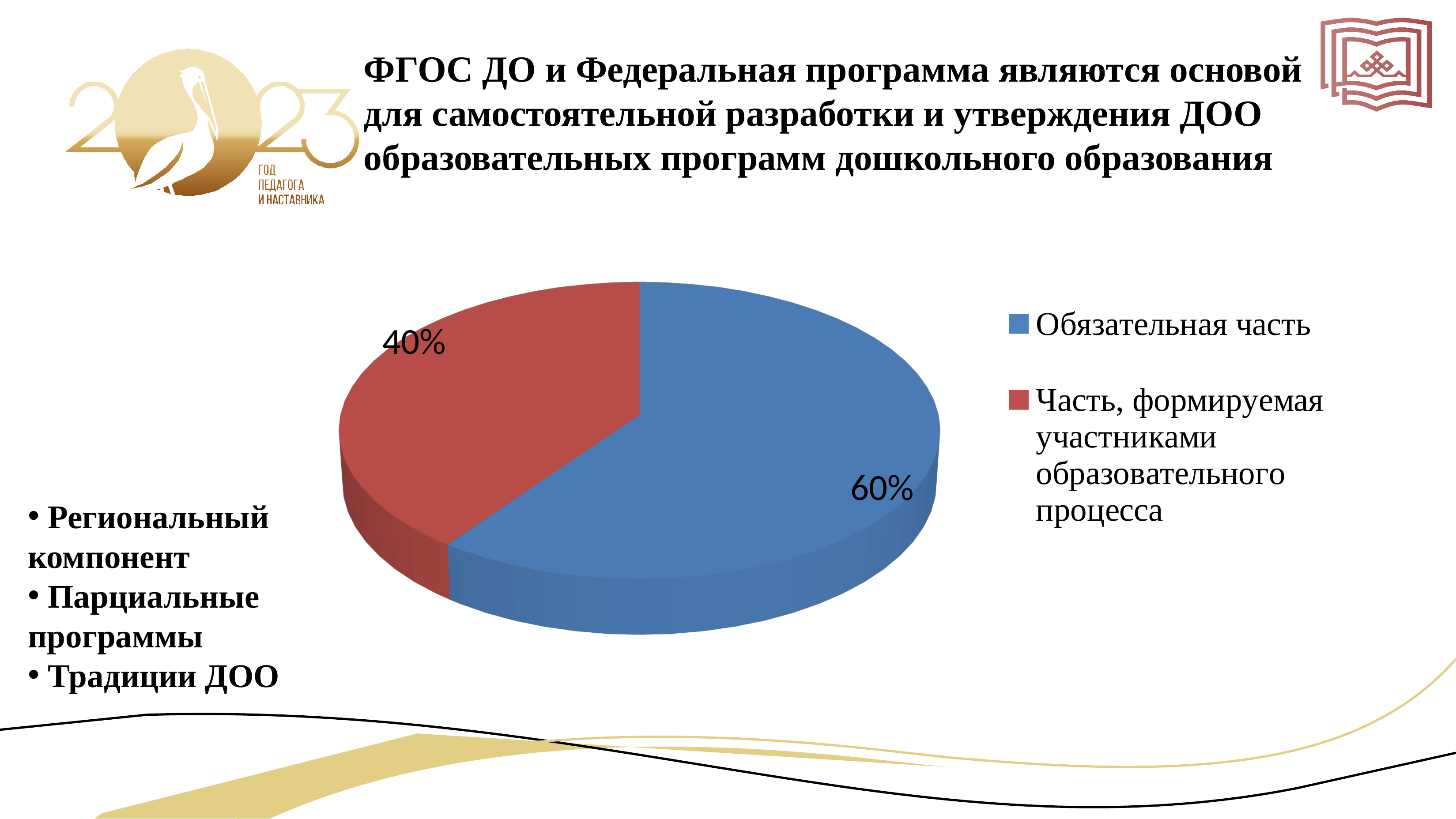
What colour is the "Обязательная часть" slice? Blue What share of the pie does "Обязательная часть" take? 60% How many entries does the legend list? 2 Which slice of the pie is the largest? Обязательная часть What is the difference in percentage points between the "Обязательная часть" slice and the "Часть, формируемая участниками образовательного процесса" slice? 20% Which is larger: the "Обязательная часть" slice or the "Часть, формируемая участниками образовательного процесса" slice? Обязательная часть What share of the pie does "Часть, формируемая участниками образовательного процесса" take? 40% Which slice of the pie is the smallest? Часть, формируемая участниками образовательного процесса How many slices does the pie chart have? 2 What kind of chart is shown on the slide? Pie chart What colour is the "Часть, формируемая участниками образовательного процесса" slice? Red